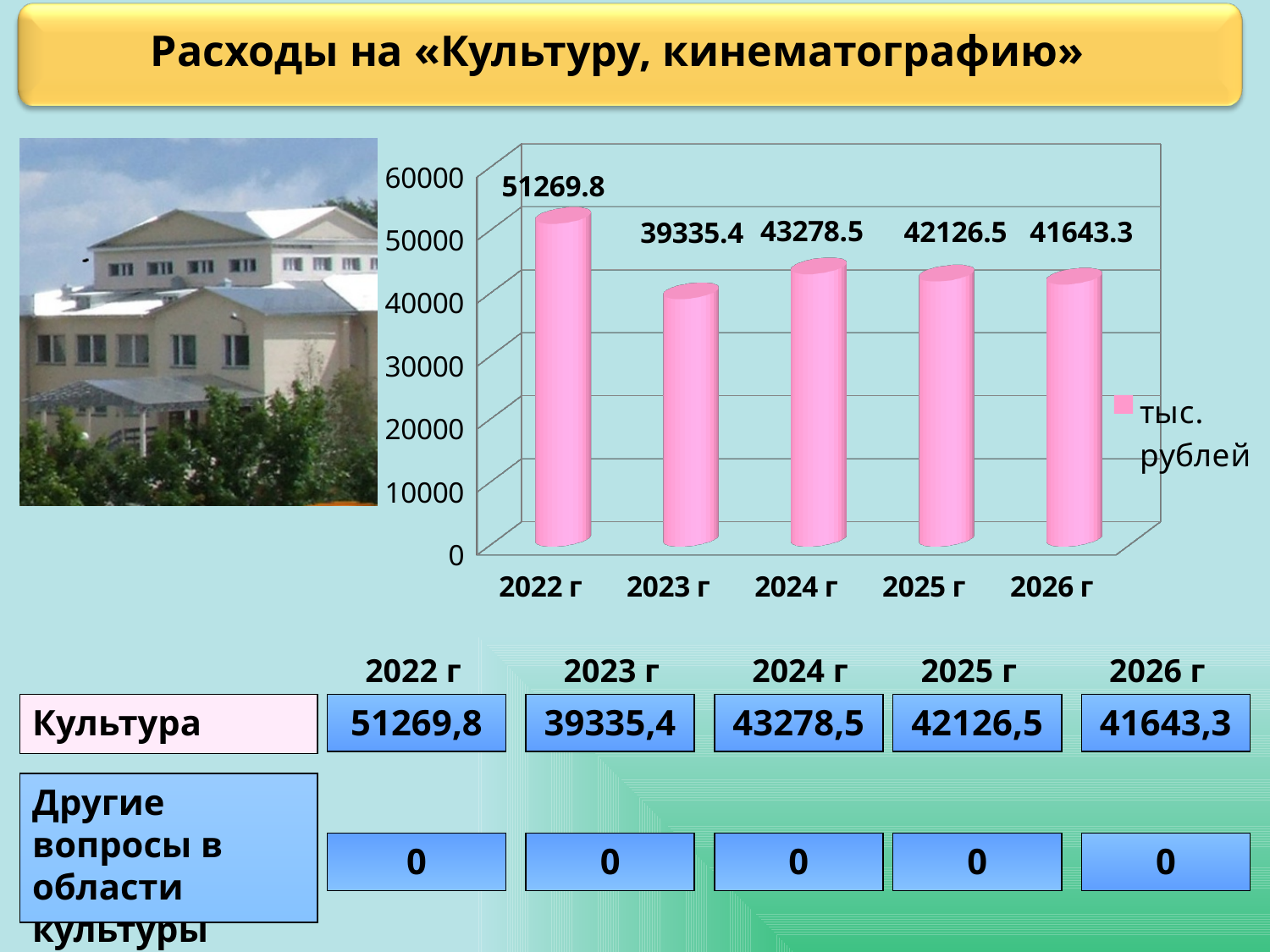
Which is larger, the value for 2024 г or the value for 2025 г? 2024 г Is the value for 2023 г greater or less than 40000? less Which year has the lowest value in the chart? 2023 г Which year has the highest value in the chart? 2022 г What is the value for 2022 г in the chart? 51269.8 What kind of chart is shown on the slide? bar chart What is the legend entry of the chart? тыс. рублей What is the value for 2026 г in the chart? 41643.3 What is the value for 2024 г in the chart? 43278.5 What is the value for 2023 г in the chart? 39335.4 What is the difference between the values for 2022 г and 2023 г? 11934.4 How many years are shown on the x axis of the chart? 5